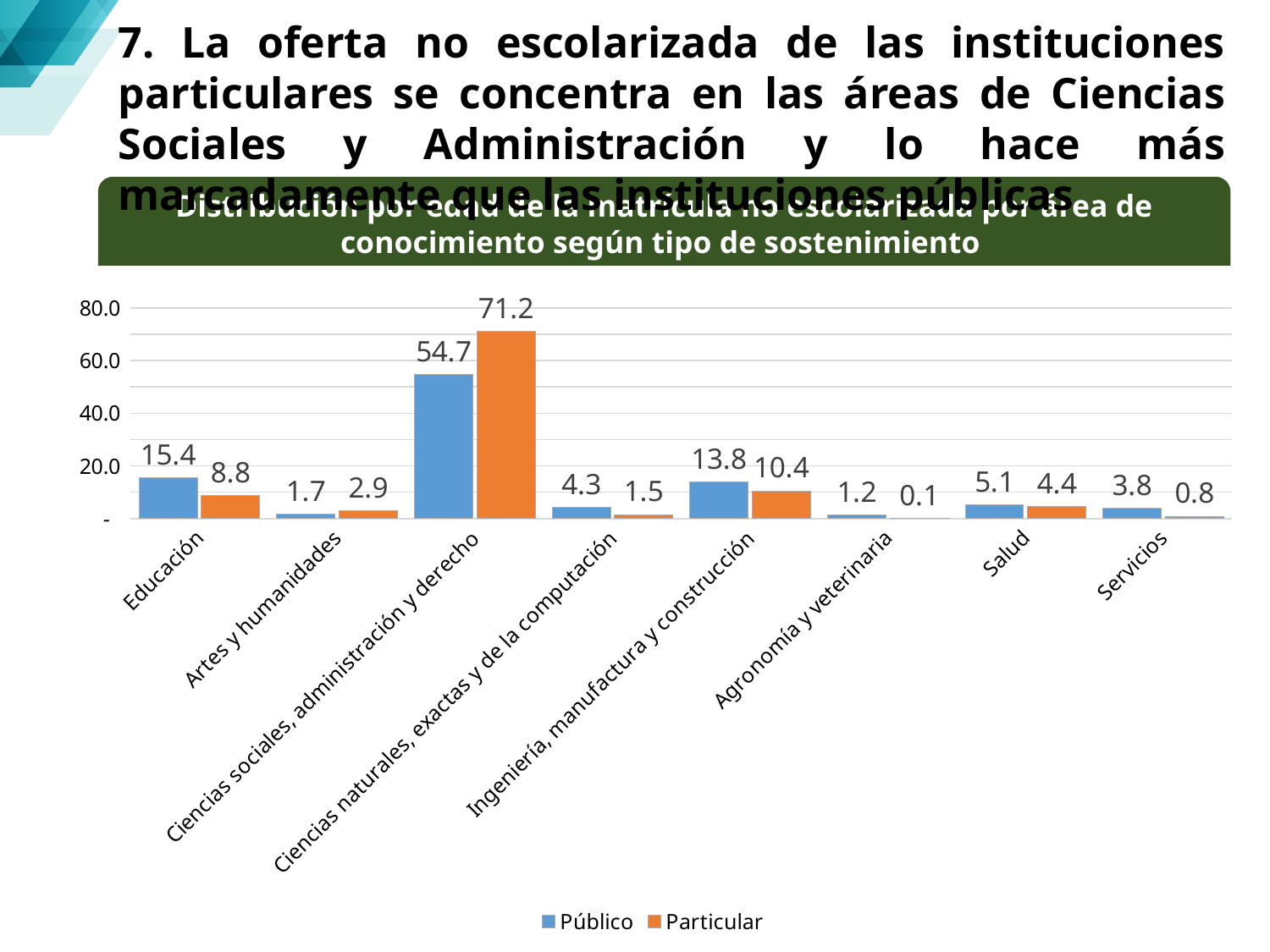
How many series does the legend list? 2 What kind of chart is shown on the slide? Bar chart What is the Público value for Ingeniería, manufactura y construcción? 13.8 How many categories are shown on the x axis? 8 What is the Particular value for Agronomía y veterinaria? 0.1 For Artes y humanidades, which series has the larger value, Público or Particular? Particular Which category has the highest Público value? Ciencias sociales, administración y derecho What is the difference between the Particular and Público values for Ciencias sociales, administración y derecho? 16.5 Which category has the lowest Particular value? Agronomía y veterinaria What is the Particular value for Ciencias sociales, administración y derecho? 71.2 What is the Público value for Educación? 15.4 Is the Público value for Ciencias sociales, administración y derecho greater or less than 40.0? greater